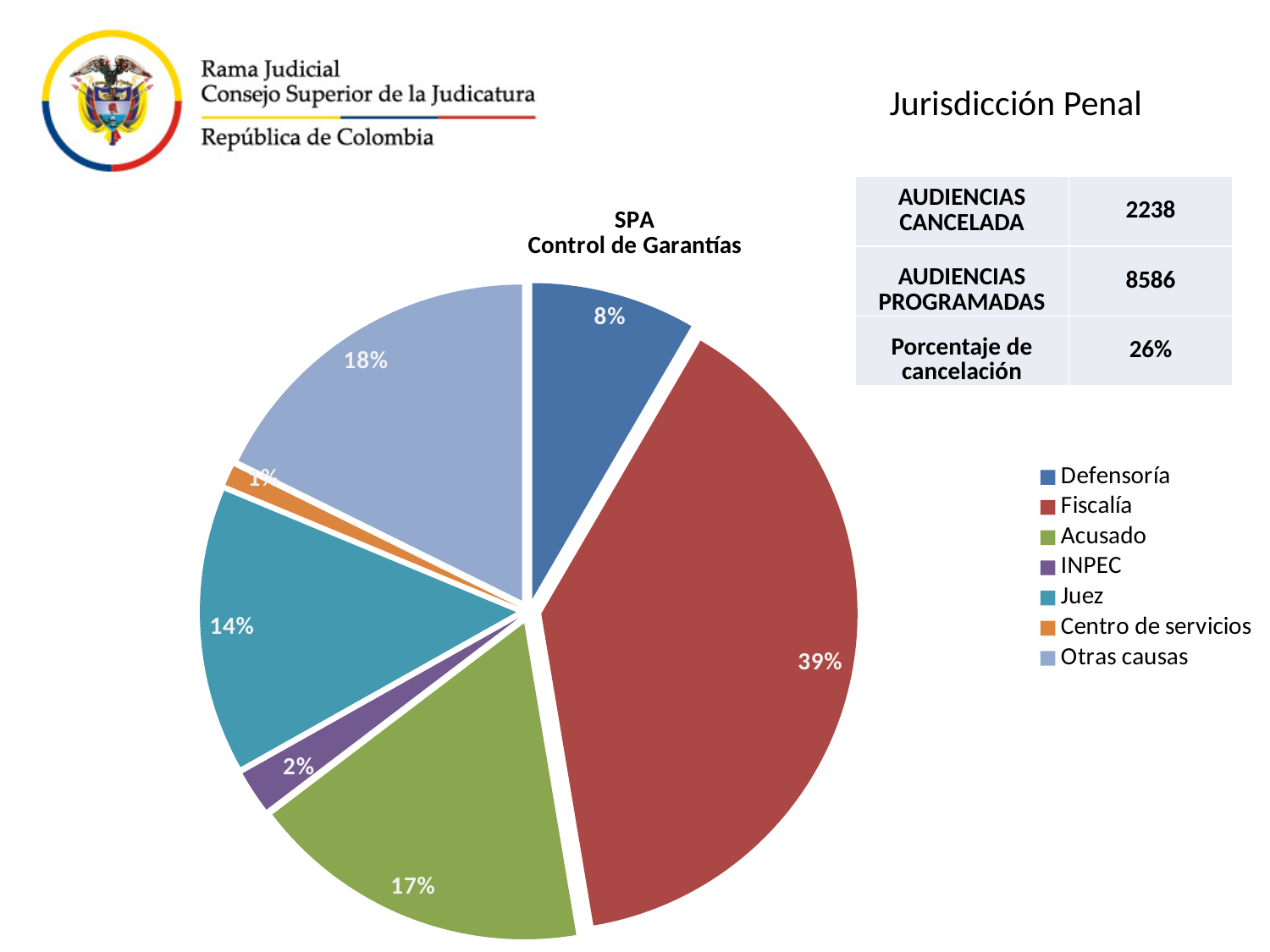
What is the title of the chart? SPA Control de Garantías How many categories does the legend list? 7 Which category has the smallest slice of the pie? Centro de servicios Which is larger, the slice for Otras causas or the slice for Juez? Otras causas Which category has the largest slice of the pie? Fiscalía What is the value shown for Acusado? 17% What share of the pie does Fiscalía represent? 39% What is the value shown for Defensoría? 8% What is the value shown for Juez? 14% What is the value shown for Otras causas? 18% What type of chart is shown on the slide? pie chart What is the difference in percentage points between Fiscalía and Acusado? 22